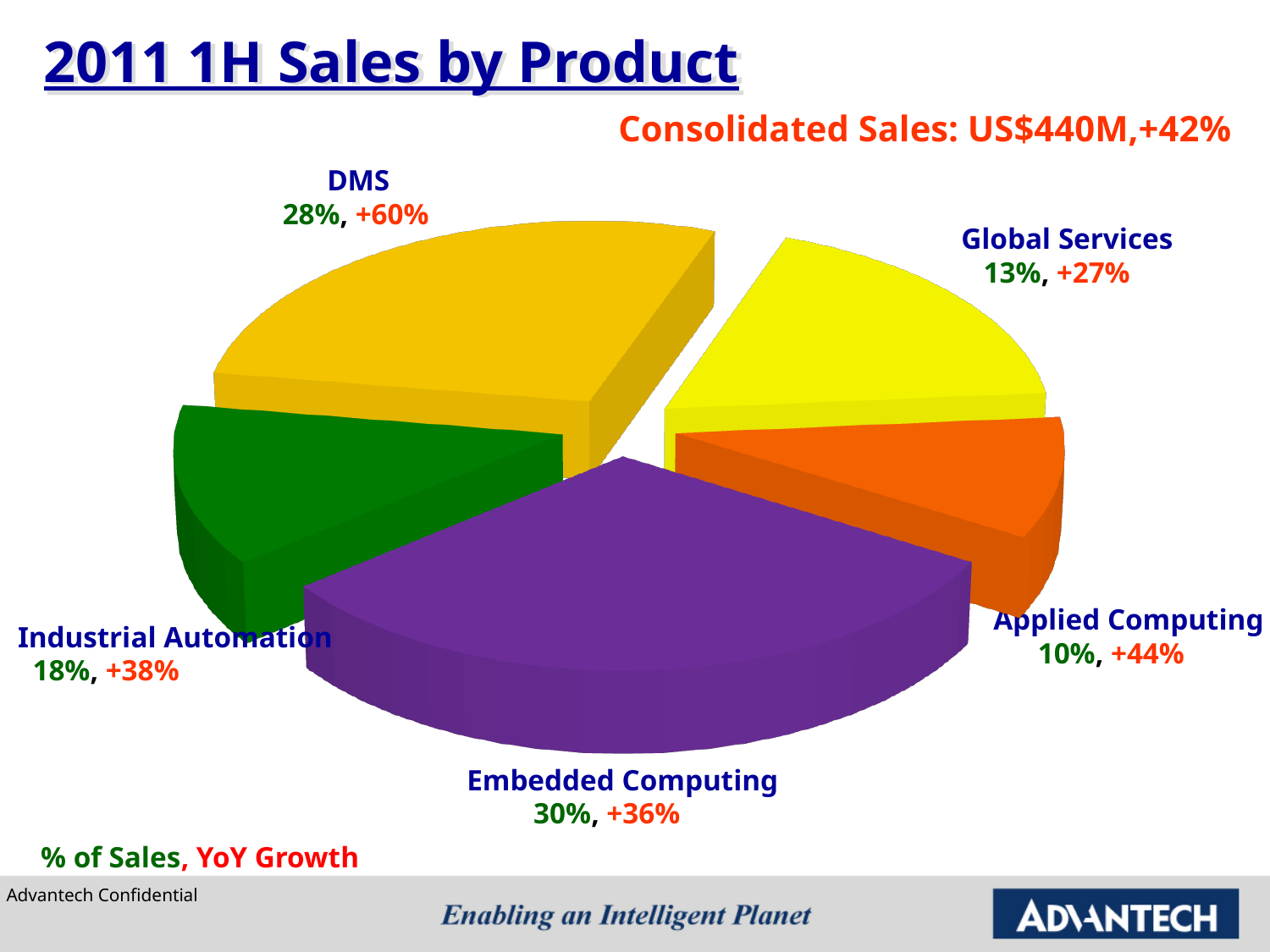
What is the % of Sales for Global Services? 13% What is the % of Sales for Embedded Computing? 30% Which has a larger share of sales, Industrial Automation or Global Services? Industrial Automation What is the YoY Growth for DMS? +60% Which product has the largest share of sales? Embedded Computing Which product has the smallest share of sales? Applied Computing What is the difference in % of Sales between DMS and Industrial Automation? 10% What is the title of the slide's chart? 2011 1H Sales by Product What is the YoY Growth for Applied Computing? +44% Which product has the highest YoY Growth? DMS How many product categories are shown in the pie chart? 5 What kind of chart is shown on the slide? pie chart